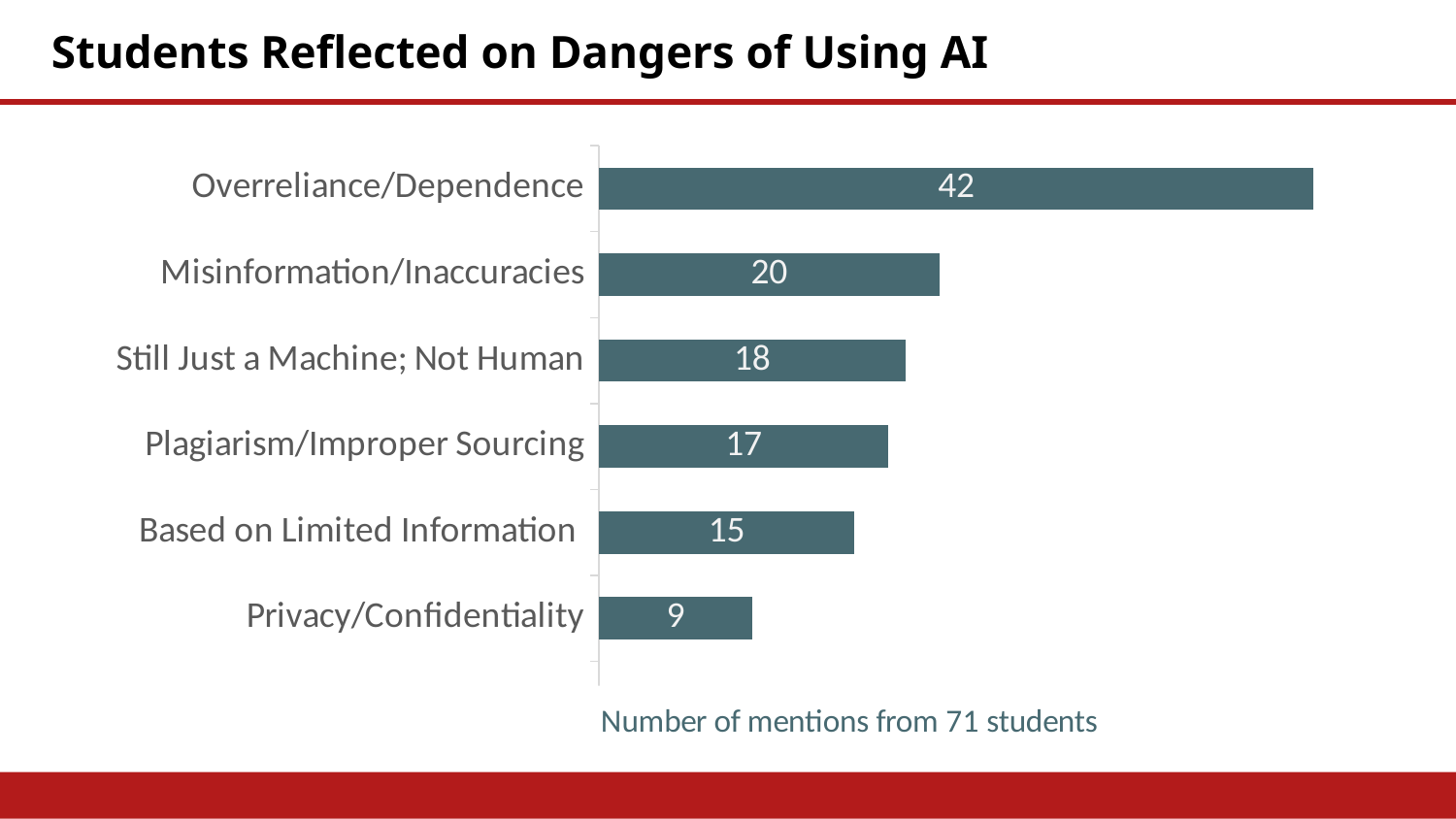
Which category has the highest number of mentions? Overreliance/Dependence How many mentions are shown for Privacy/Confidentiality? 9 What is the difference between the mentions for Overreliance/Dependence and Misinformation/Inaccuracies? 22 How many categories are shown in the chart? 6 How many mentions did Overreliance/Dependence receive? 42 Which has more mentions: Still Just a Machine; Not Human or Plagiarism/Improper Sourcing? Still Just a Machine; Not Human Which category has the lowest number of mentions? Privacy/Confidentiality What type of chart is shown on the slide? Bar chart What is the difference between the values for Based on Limited Information and Privacy/Confidentiality? 6 What is the value for Plagiarism/Improper Sourcing? 17 What is the label shown below the chart describing the values? Number of mentions from 71 students What is the value for Misinformation/Inaccuracies? 20